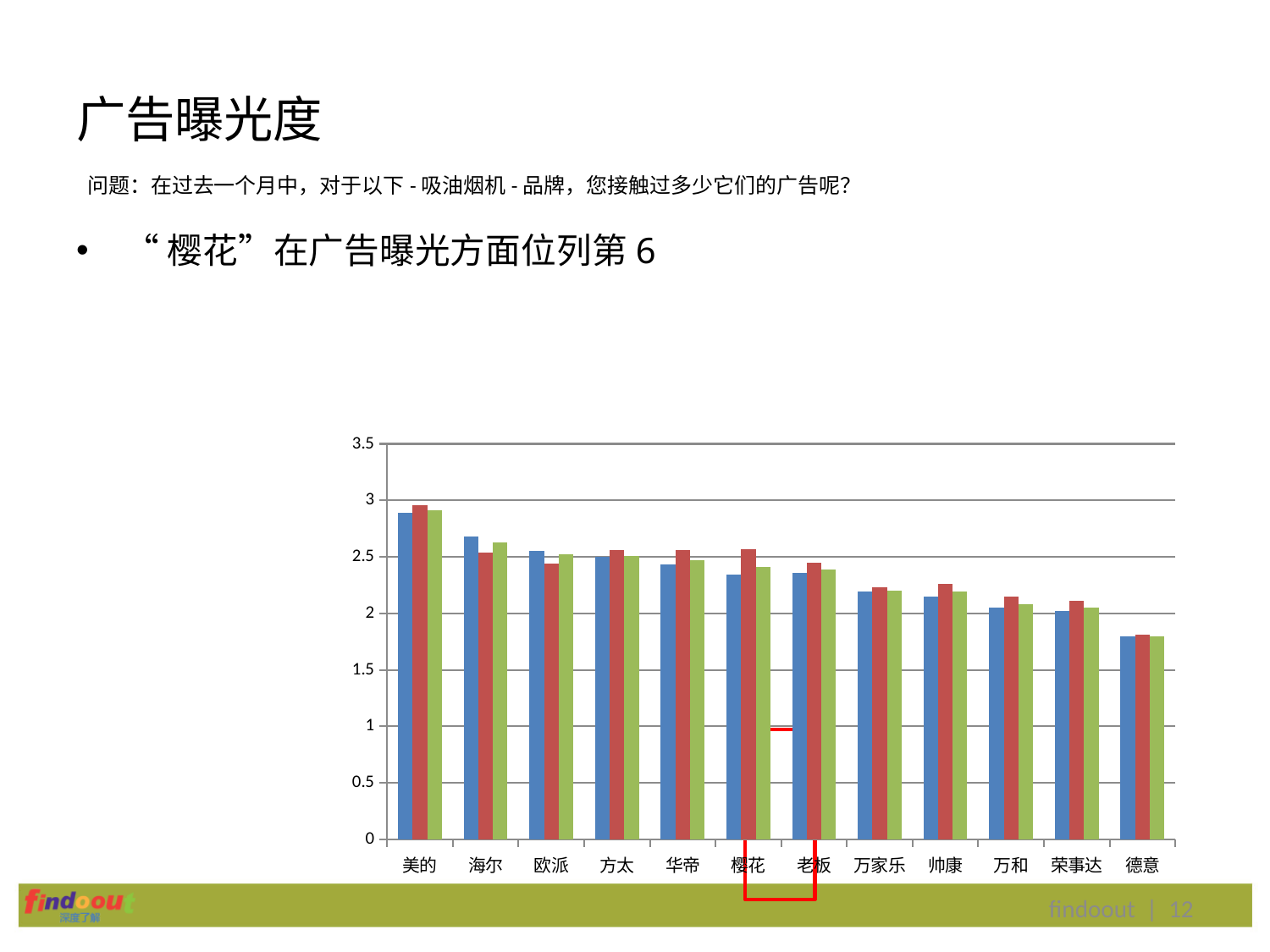
Is the value of the red bar for 帅康 greater or less than 2? greater Is the value of the blue bar for 樱花 greater or less than 2.5? less Is the value of the blue bar for 德意 greater or less than 2? less Which brand has the highest bars in the chart? 美的 How many brands (categories) are shown on the x axis of the chart? 12 Do the values generally rise or fall moving from left to right along the x axis? fall Which brand has the lowest bars in the chart? 德意 What kind of chart is shown on the slide? bar chart How many bars are plotted for each brand in the chart? 3 Which brand has a higher blue bar, 海尔 or 万和? 海尔